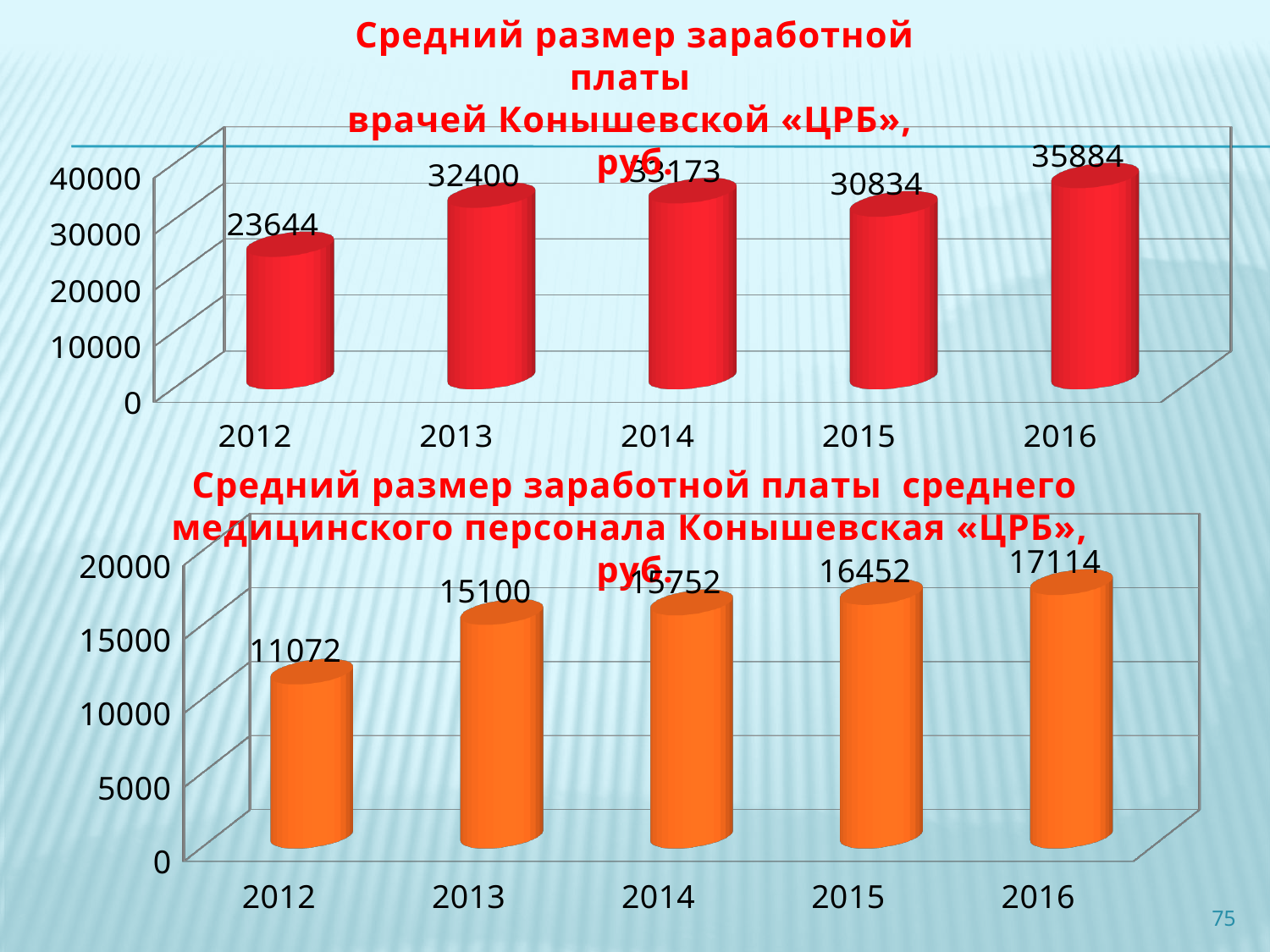
In the bottom chart, which year has the lowest value? 2012 In the top chart, what is the difference between the values for 2016 and 2012? 12240 In the top chart, which is larger, the value for 2014 or the value for 2015? 2014 How many years are shown on the x axis of the bottom chart? 5 In the top chart, which year has the lowest value? 2012 In the top chart, which year has the highest value? 2016 In the bottom chart, what is the average salary of mid-level medical staff in 2013? 15100 In the bottom chart, do the values rise or fall from 2012 to 2016? rise In the top chart, what is the value for 2015? 30834 In the bottom chart, what is the difference between the values for 2015 and 2014? 700 In the top chart, what is the average salary of doctors in 2012? 23644 In the bottom chart, what is the value for 2016? 17114